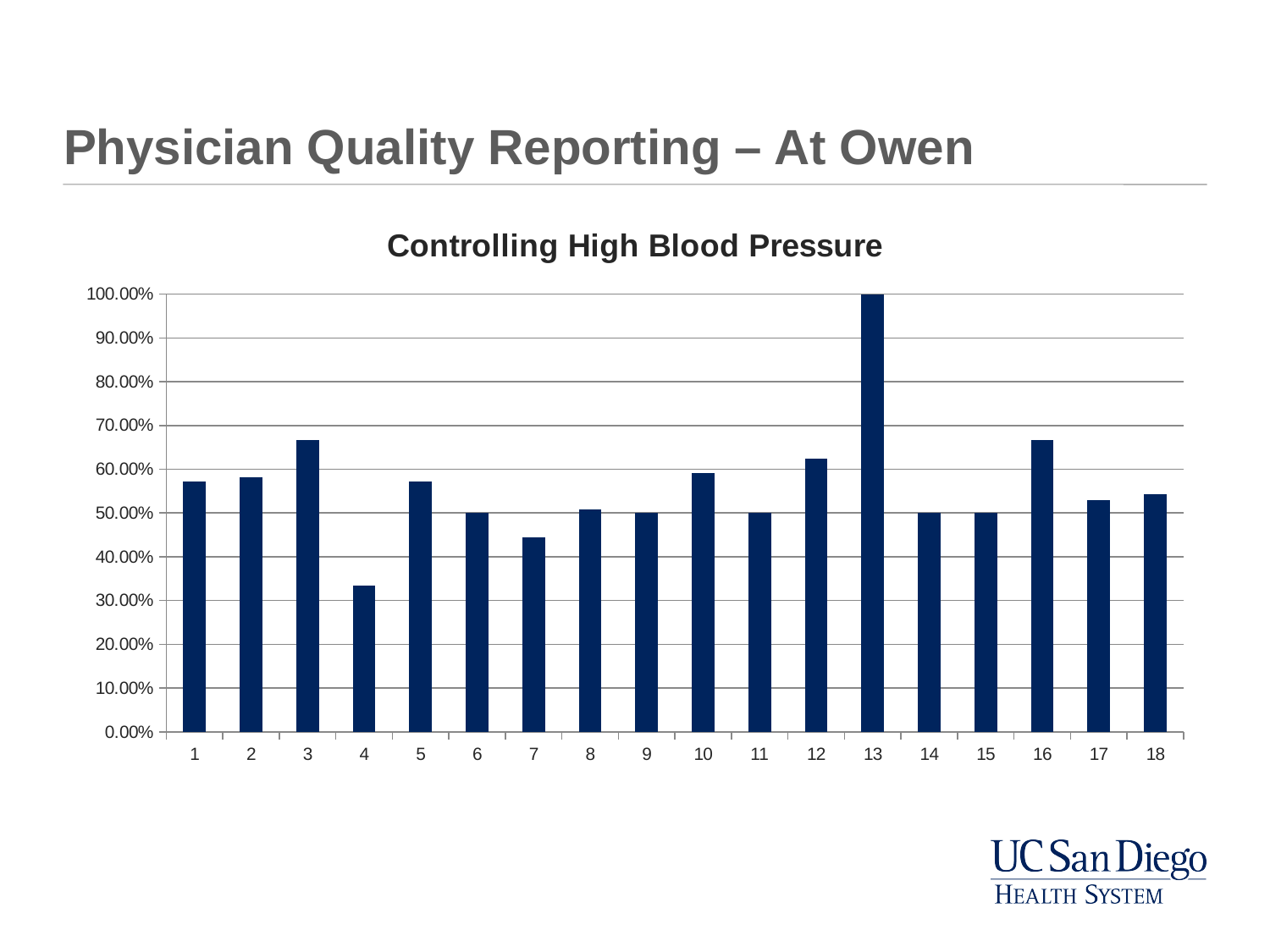
Is the value for category 3 greater or less than 60.00%? greater Which category has the highest value? 13 What is the value for category 13? 100.00% Is the value for category 16 greater or less than 60.00%? greater How many categories (bars) are shown on the x axis? 18 Is the value for category 4 greater or less than 40.00%? less Which is larger, the value for category 3 or category 4? 3 What is the title of the chart? Controlling High Blood Pressure Which category has the lowest value? 4 What type of chart is shown on the slide? bar chart Which is larger, the value for category 13 or category 16? 13